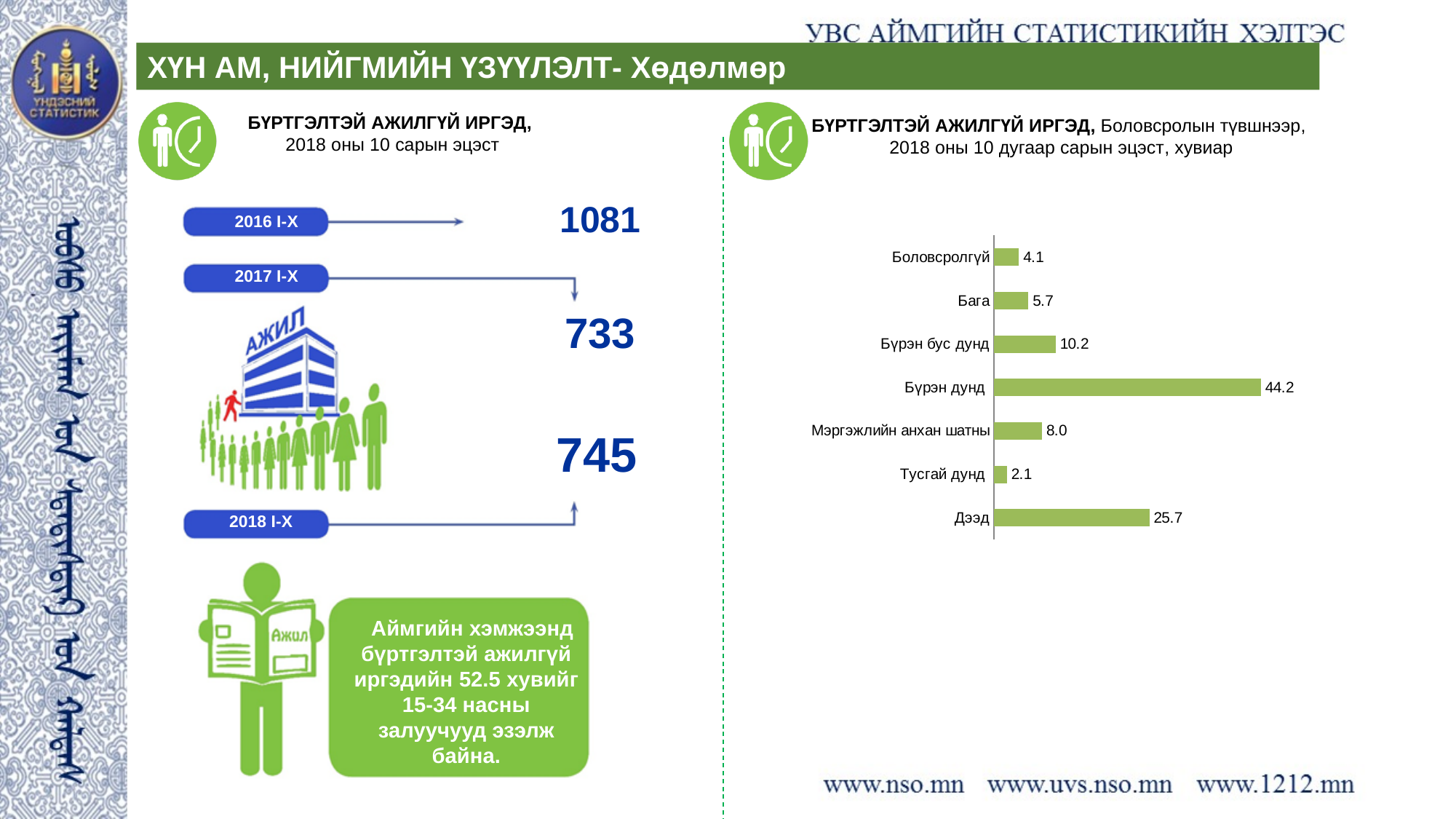
In the bar chart, what is the value for Бүрэн дунд? 44.2 In the bar chart, what is the difference between the values for Бүрэн бус дунд and Бага? 4.5 Which category has the lowest value in the bar chart? Тусгай дунд How many categories are shown in the bar chart? 7 What colour are the bars in the bar chart? green In the bar chart, what is the value for Мэргэжлийн анхан шатны? 8.0 In the bar chart, what is the value for Дээд? 25.7 In the bar chart, what is the value for Боловсролгүй? 4.1 In the bar chart, which is larger: the value for Бага or the value for Мэргэжлийн анхан шатны? Мэргэжлийн анхан шатны What kind of chart is shown on the right side of the slide? bar chart Which category has the highest value in the bar chart? Бүрэн дунд In the bar chart, what is the difference between the values for Бүрэн дунд and Дээд? 18.5